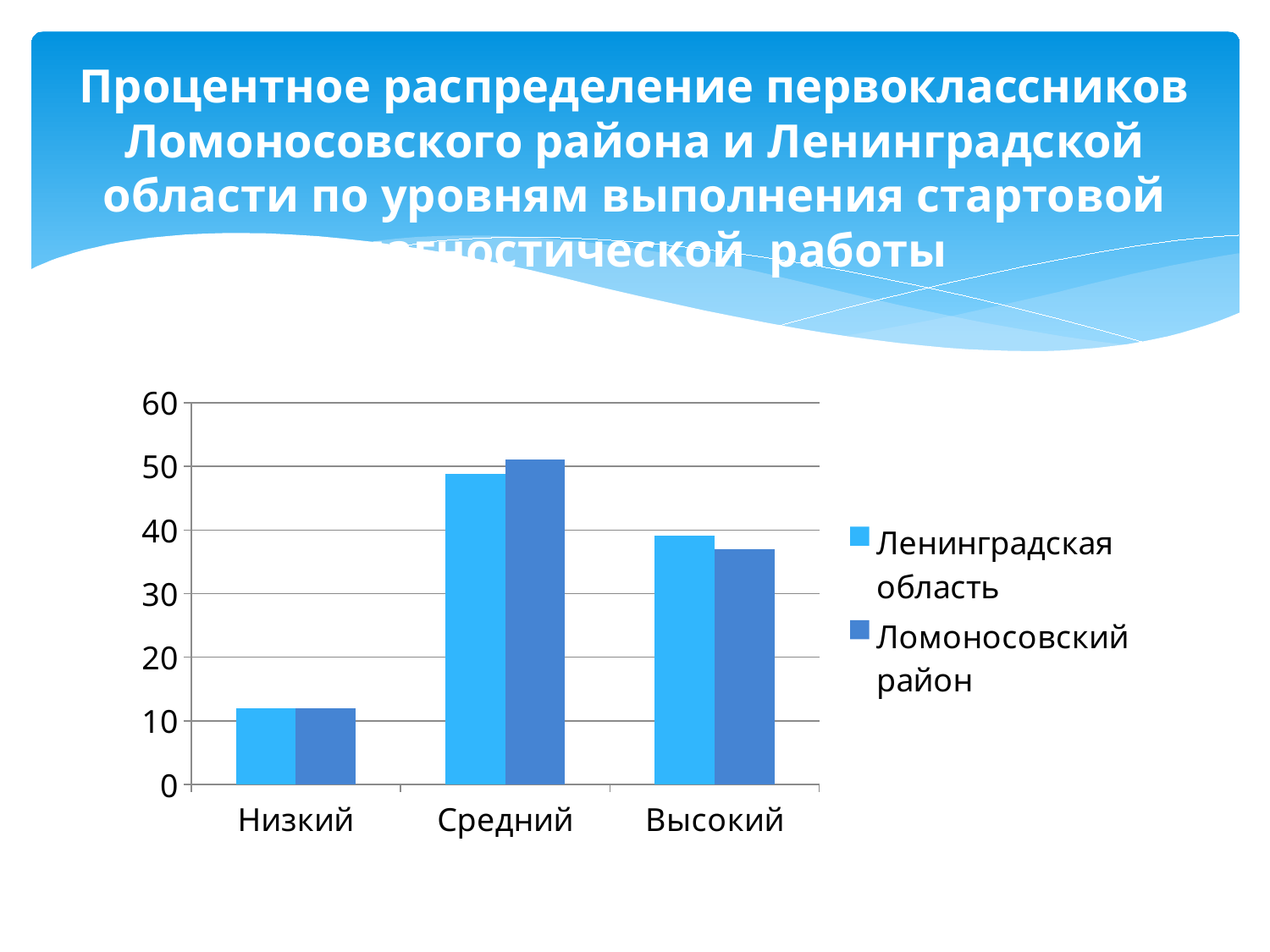
Which series is shown in the darker blue colour? Ломоносовский район For Ленинградская область, which is larger: the value for Средний or the value for Высокий? Средний How many series does the legend list? 2 Which category has the highest value for Ломоносовский район? Средний Which category has the highest value for Ленинградская область? Средний Is the value for Высокий for Ленинградская область greater or less than 50? less How many categories are shown on the x axis? 3 Is the value for Средний for Ломоносовский район greater or less than 40? greater Is the value for Высокий for Ломоносовский район greater or less than 30? greater Which category has the lowest value for Ломоносовский район? Низкий What kind of chart is shown on the slide? bar chart